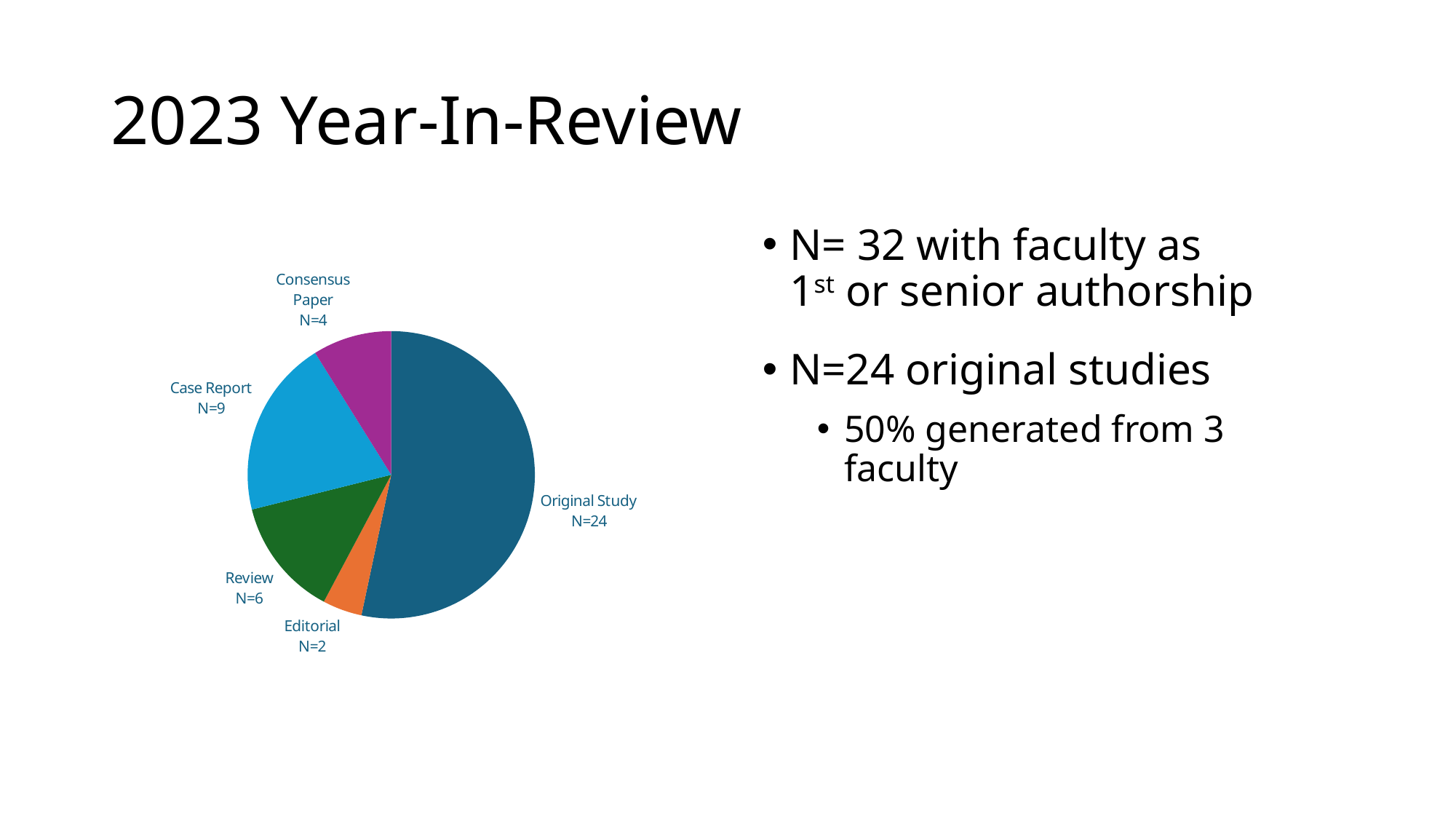
Which category has the smallest slice in the pie chart? Editorial What is the value for Original Study in the pie chart? N=24 Which category has the largest slice in the pie chart? Original Study How many categories does the pie chart show? 5 What is the value for Case Report in the pie chart? N=9 Which is larger, Review or Consensus Paper? Review What type of chart is shown on the slide? Pie chart What is the value for Editorial in the pie chart? N=2 What share of the pie does Case Report represent? 20% What is the difference between the Original Study and Case Report values? 15 What is the total of all the values in the pie chart? 45 What is the value for Consensus Paper in the pie chart? N=4